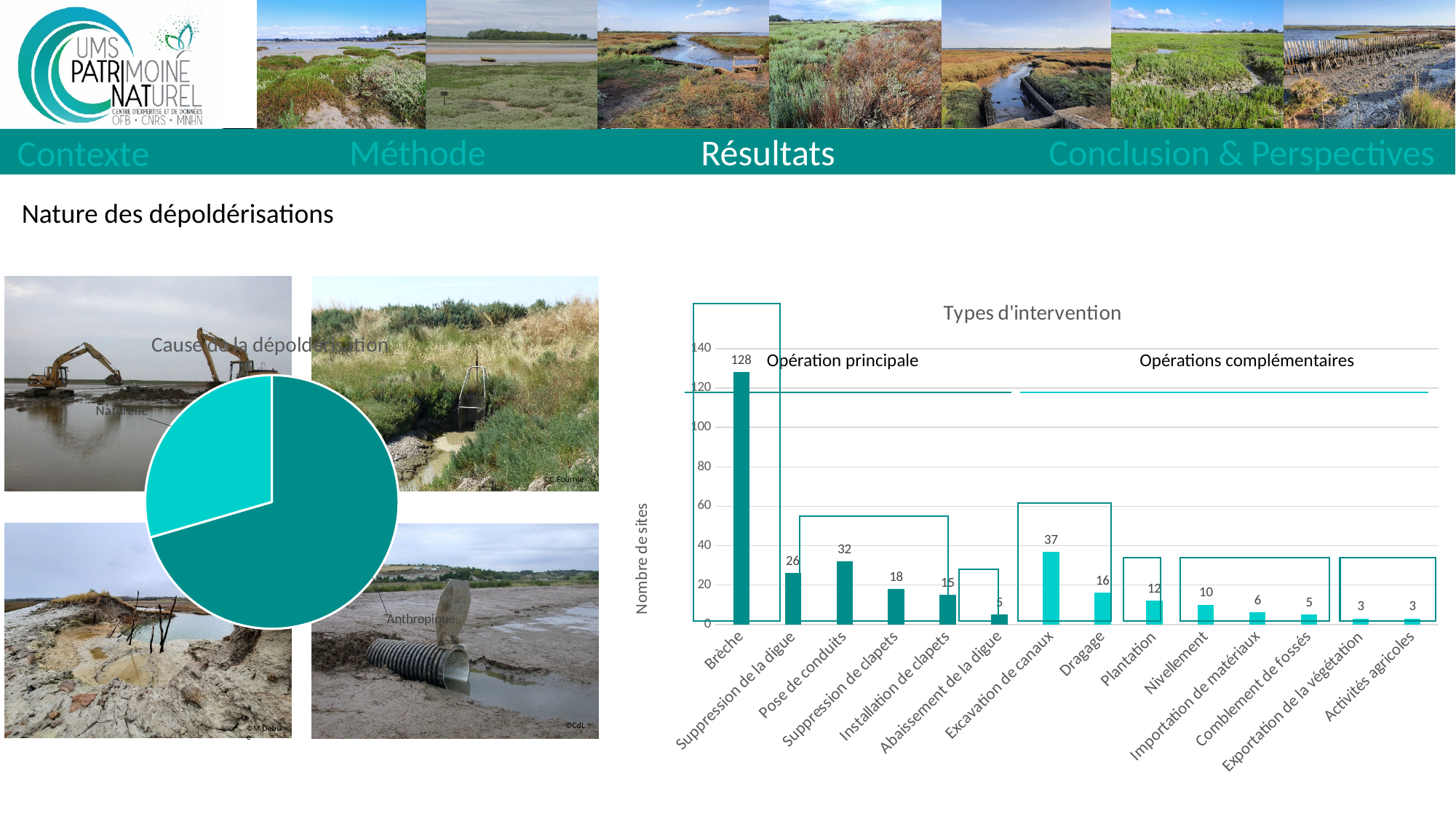
What kind of chart is 'Types d'intervention'? Bar chart In the 'Types d'intervention' chart, how many intervention categories are shown on the x axis? 14 In the 'Types d'intervention' chart, how many sites are shown for Brèche? 128 In the 'Types d'intervention' chart, what is the difference between Brèche and Suppression de la digue? 102 In the 'Types d'intervention' chart, what is the value for Pose de conduits? 32 In the 'Types d'intervention' chart, what is the difference between Excavation de canaux and Dragage? 21 In the 'Types d'intervention' chart, which is larger: Dragage or Plantation? Dragage What is the y-axis title of the 'Types d'intervention' chart? Nombre de sites In the 'Types d'intervention' chart, which intervention type has the highest number of sites? Brèche What kind of chart is 'Cause de la dépoldérisation'? Pie chart In the 'Cause de la dépoldérisation' pie chart, which slice is larger: Naturelle or Anthropique? Anthropique In the 'Types d'intervention' chart, what is the value for Excavation de canaux? 37